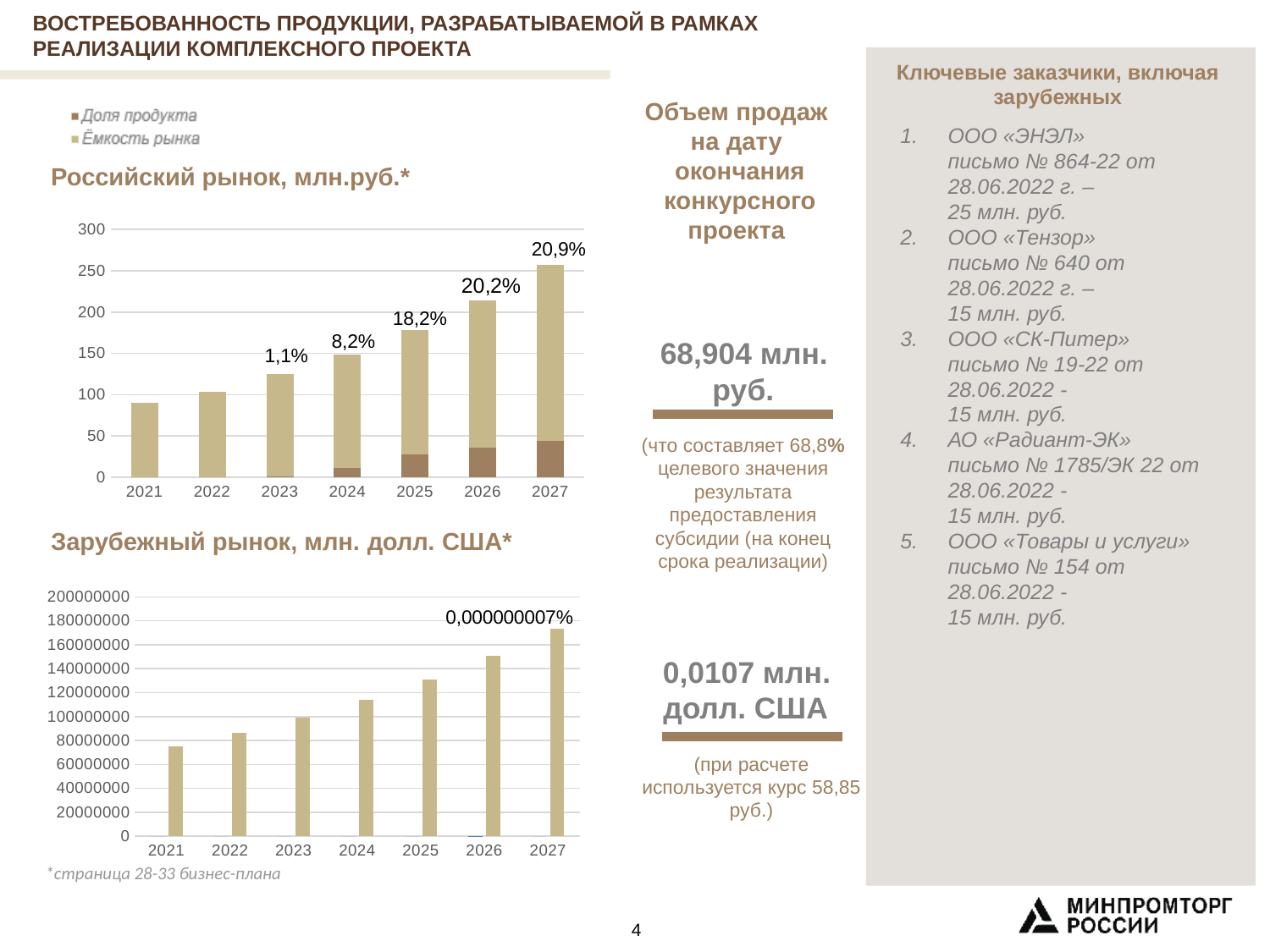
In the "Российский рынок, млн.руб.*" chart, what is the difference between the percentage labels for 2027 and 2026? 0,7% How many series does the legend list for the "Российский рынок, млн.руб.*" chart? 2 In the "Зарубежный рынок, млн. долл. США*" chart, is the value for 2021 greater or less than 80000000? less In the "Российский рынок, млн.руб.*" chart, which year has the tallest bar? 2027 In the "Российский рынок, млн.руб.*" chart, what percentage label is shown above the 2024 bar? 8,2% In the "Зарубежный рынок, млн. долл. США*" chart, what data label is shown above the 2027 bar? 0,000000007% In the "Российский рынок, млн.руб.*" chart, is the total bar height for 2021 greater or less than 100? less In the "Российский рынок, млн.руб.*" chart, what percentage label is shown above the 2027 bar? 20,9% In the "Российский рынок, млн.руб.*" chart, is the total bar height for 2027 greater or less than 250? greater In the "Зарубежный рынок, млн. долл. США*" chart, do the bar values rise or fall from 2021 to 2027? rise In the "Российский рынок, млн.руб.*" chart, what percentage label is shown above the 2023 bar? 1,1% What type of chart is the "Российский рынок, млн.руб.*" chart? bar chart